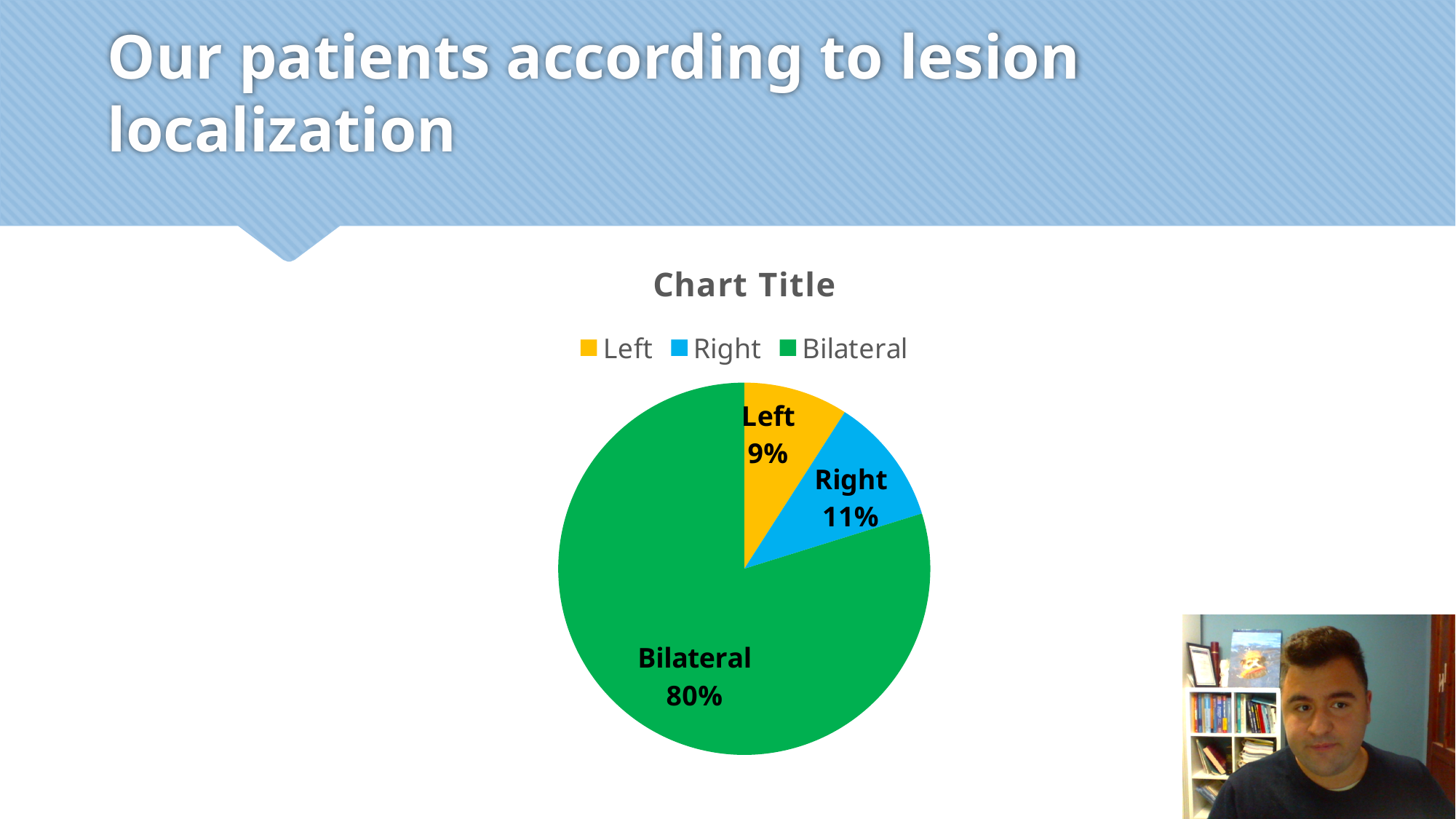
Which slice is larger, Left or Right? Right Which lesion localization category has the largest share of patients? Bilateral How many entries does the legend list? 3 How many categories are shown in the pie chart? 3 What percentage of patients have a Left lesion localization? 9% What percentage of patients have a Bilateral lesion localization? 80% Which lesion localization category has the smallest share of patients? Left What percentage of patients have a Right lesion localization? 11% What is the difference in percentage points between the Right and Left slices? 2 What kind of chart is shown on the slide? Pie chart What is the difference in percentage points between the Bilateral and Right slices? 69 What colour is the Bilateral slice of the pie chart? Green